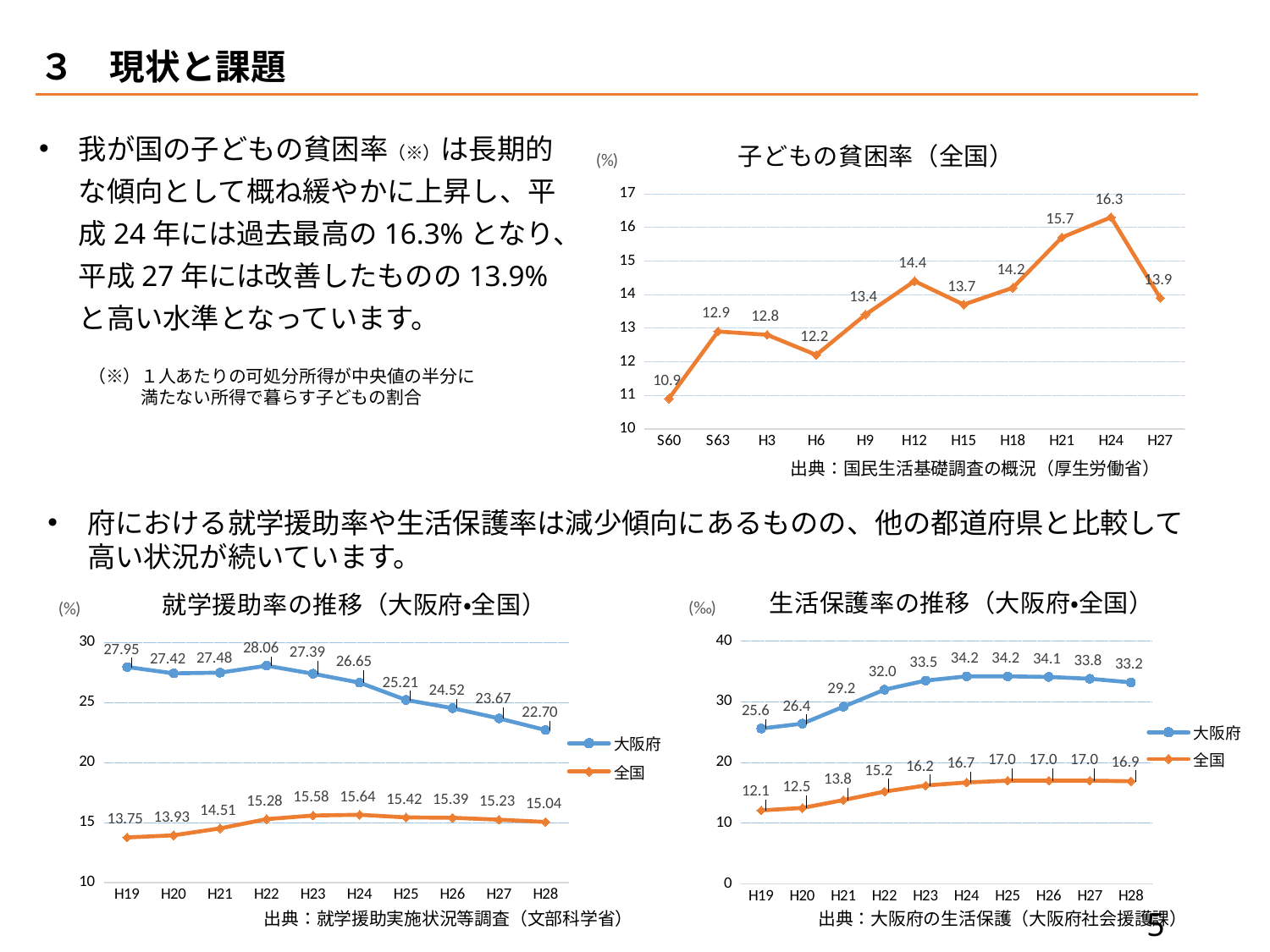
In the 生活保護率の推移（大阪府・全国） chart, what is the 全国 value for H19? 12.1 In the 生活保護率の推移（大阪府・全国） chart, what is the difference between the 大阪府 and 全国 values for H28? 16.3 In the 子どもの貧困率（全国） chart, what is the value for H24? 16.3 In the 就学援助率の推移（大阪府・全国） chart, does the 大阪府 series rise or fall from H22 to H28? Fall In the 就学援助率の推移（大阪府・全国） chart, what is the 大阪府 value for H28? 22.70 In the 生活保護率の推移（大阪府・全国） chart, which series has the larger value for H24, 大阪府 or 全国? 大阪府 How many series does the legend of the 就学援助率の推移（大阪府・全国） chart list? 2 How many data points are plotted in the 子どもの貧困率（全国） chart? 11 In the 子どもの貧困率（全国） chart, what is the difference between the H24 value and the H27 value? 2.4 In the 子どもの貧困率（全国） chart, which year has the lowest value? S60 In the 就学援助率の推移（大阪府・全国） chart, which year has the highest 大阪府 value? H22 What kind of chart is the 子どもの貧困率（全国） chart? Line chart